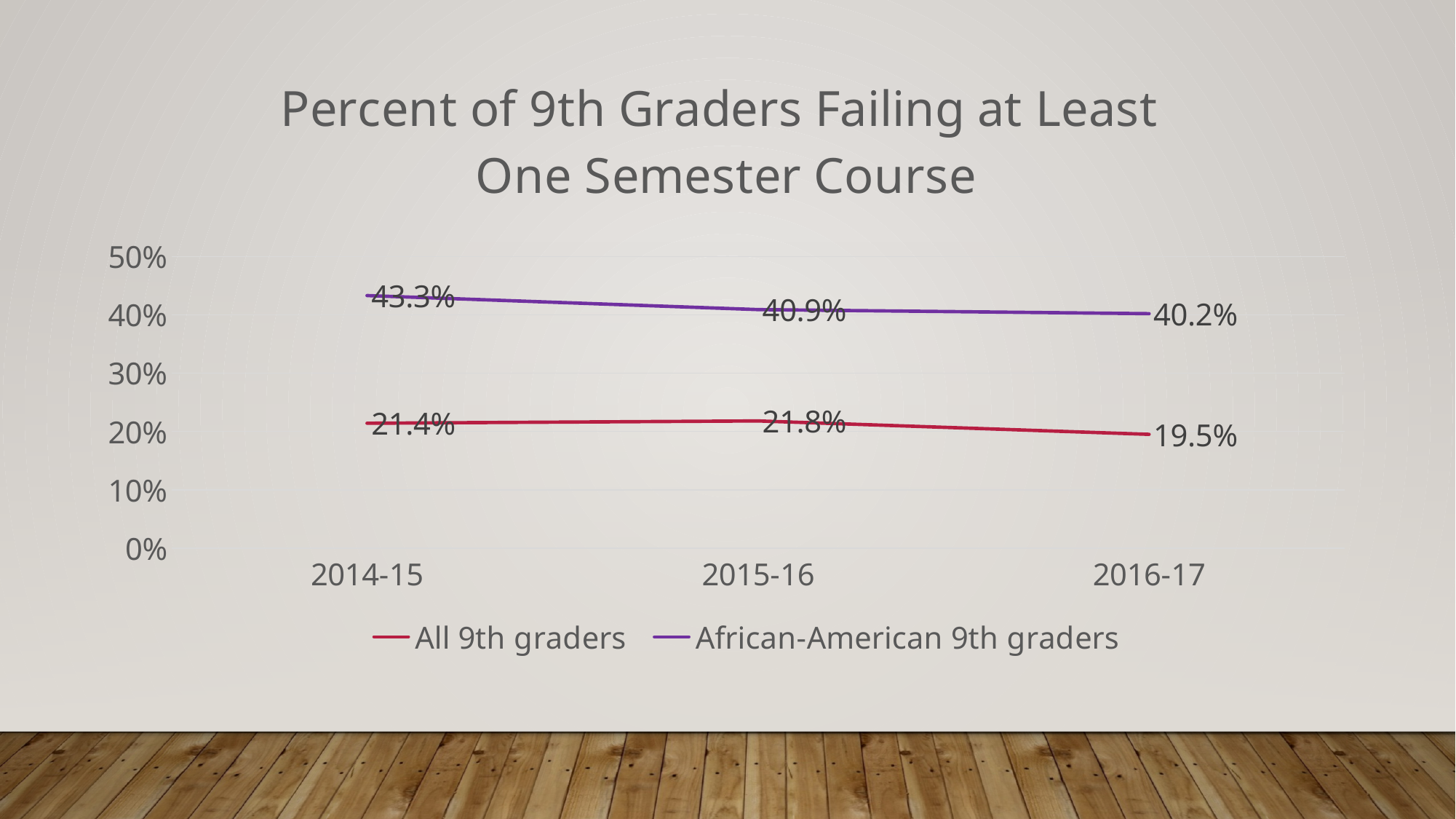
What is the difference between the African-American 9th graders value and the all 9th graders value in 2014-15? 21.9% In which school year was the percentage of African-American 9th graders failing at least one semester course lowest? 2016-17 How many series does the legend list? 2 How many school years are shown on the x axis? 3 What percent of all 9th graders failed at least one semester course in 2014-15? 21.4% Does the value for African-American 9th graders rise or fall from 2014-15 to 2016-17? Fall In which school year was the percentage of all 9th graders failing at least one semester course highest? 2015-16 Which series has the higher value in 2016-17, all 9th graders or African-American 9th graders? African-American 9th graders By how much did the value for all 9th graders change from 2015-16 to 2016-17? 2.3% What is the value for African-American 9th graders in 2016-17? 40.2% What kind of chart is shown on the slide? Line chart What is the value for African-American 9th graders in 2015-16? 40.9%